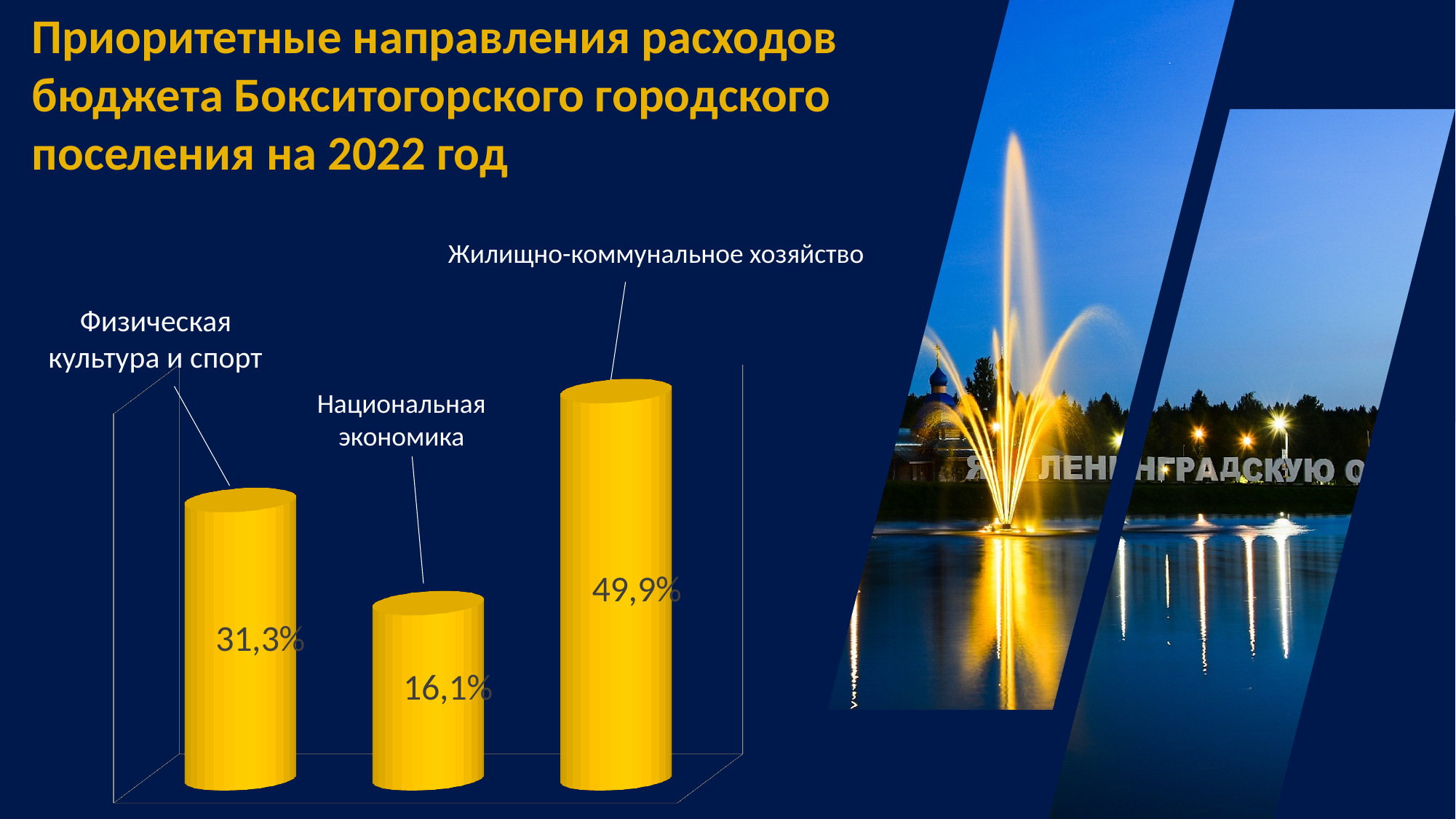
What colour are the bars in the chart? yellow What kind of chart is shown on the slide? bar chart Which category has the lowest value? Национальная экономика What is the difference between the values for Жилищно-коммунальное хозяйство and Физическая культура и спорт? 18,6% What year does the slide title say the budget expenditure priorities are for? 2022 What is the value for Жилищно-коммунальное хозяйство? 49,9% What is the value for Национальная экономика? 16,1% What is the difference between the values for Физическая культура и спорт and Национальная экономика? 15,2% How many categories are shown in the chart? 3 What is the value for Физическая культура и спорт? 31,3% Which category has the highest value? Жилищно-коммунальное хозяйство Which is larger, the value for Физическая культура и спорт or the value for Национальная экономика? Физическая культура и спорт